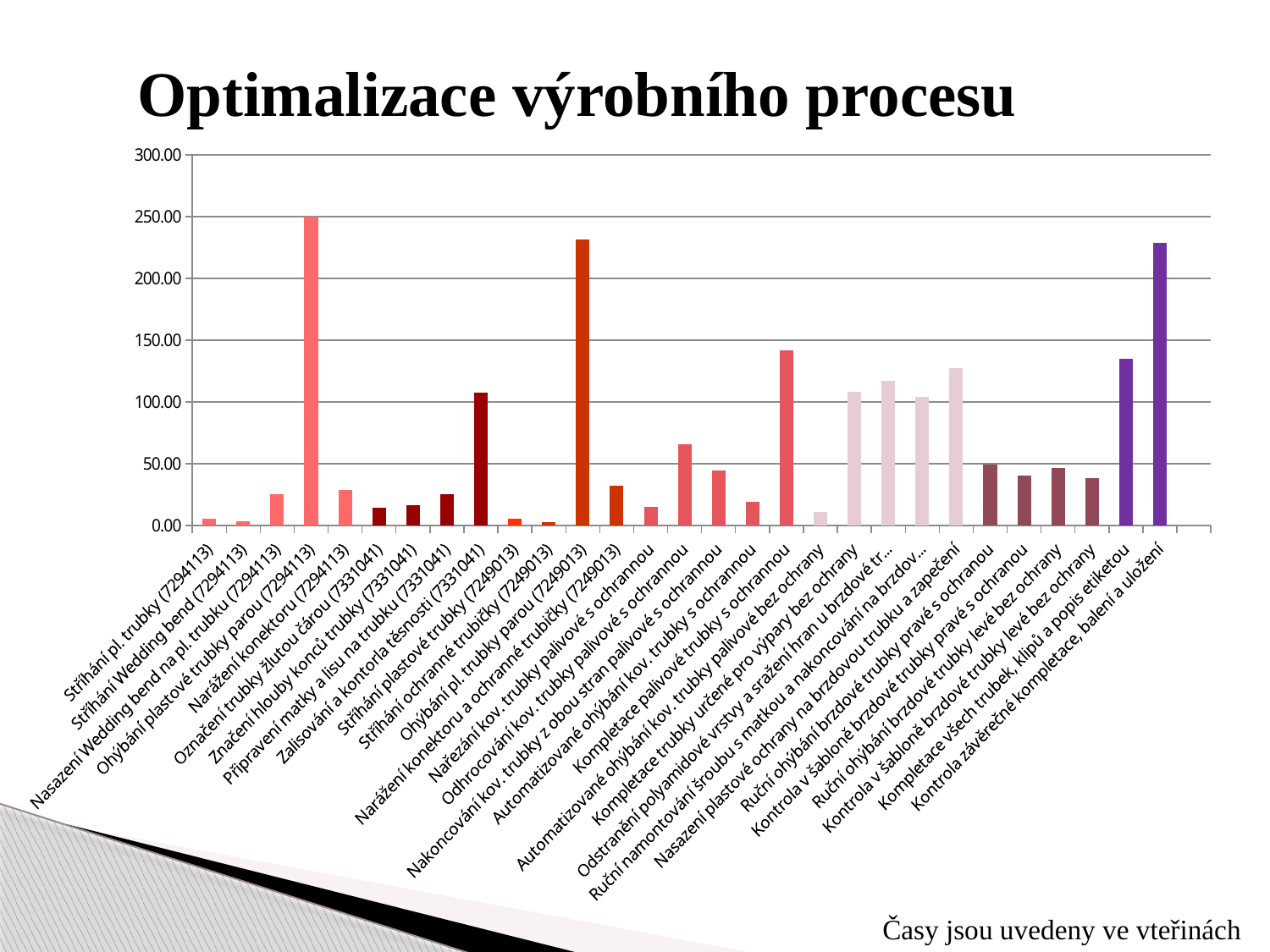
Is the value for Odhrocování kov. trubky palivové s ochrannou greater or less than 50.00? greater Which is larger: the value for Ohýbání pl. trubky parou (7249013) or the value for Narážení konektoru a ochranné trubičky (7249013)? Ohýbání pl. trubky parou (7249013) How many categories (bars) are plotted in the chart? 29 Which category has the highest value in the chart? Ohýbání plastové trubky parou (7294113) What is the title of the chart on the slide? Optimalizace výrobního procesu According to the note on the slide, in what units are the times given? ve vteřinách (seconds) Is the value for Kompletace všech trubek, klipů a popis etiketou greater or less than 150.00? less Which is larger: the value for Odhrocování kov. trubky palivové s ochrannou or the value for Nakoncování kov. trubky z obou stran palivové s ochrannou? Odhrocování kov. trubky palivové s ochrannou Is the value for Kompletace palivové trubky s ochrannou greater or less than 100.00? greater What kind of chart is shown on the slide? bar chart